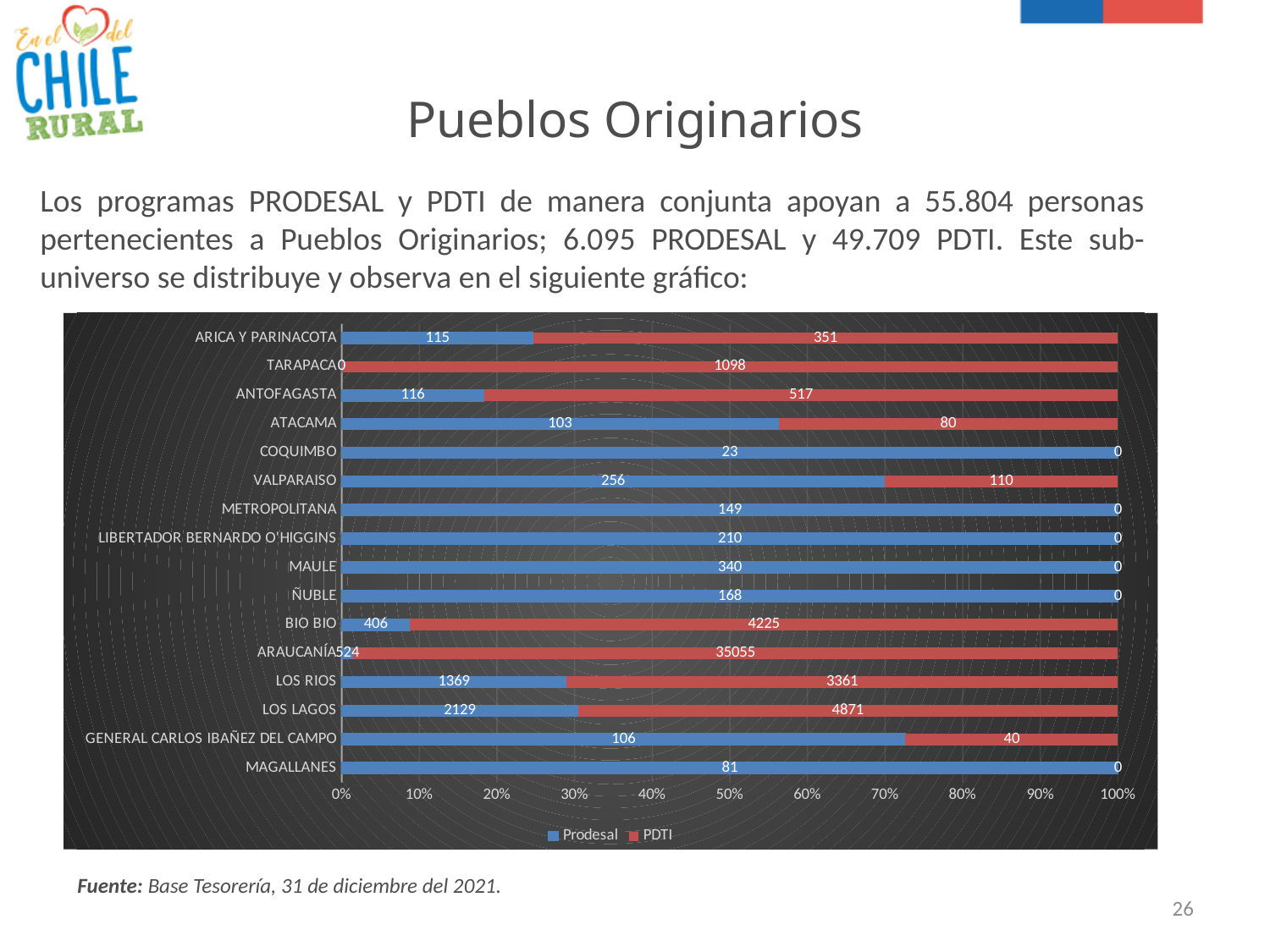
Which colour represents the PDTI series in the chart? Red Which region has the highest PDTI value? ARAUCANÍA What kind of chart is shown on the slide? Stacked bar chart Which is larger for VALPARAISO, the Prodesal value or the PDTI value? Prodesal What is the Prodesal value for LOS LAGOS? 2129 What is the PDTI value for ARICA Y PARINACOTA? 351 What is the difference between the PDTI and Prodesal values for BIO BIO? 3819 What is the PDTI value for ARAUCANÍA? 35055 What is the total of Prodesal and PDTI for LOS LAGOS? 7000 How many regions are shown on the chart? 16 Which region has the highest Prodesal value? LOS LAGOS How many series does the legend list? 2